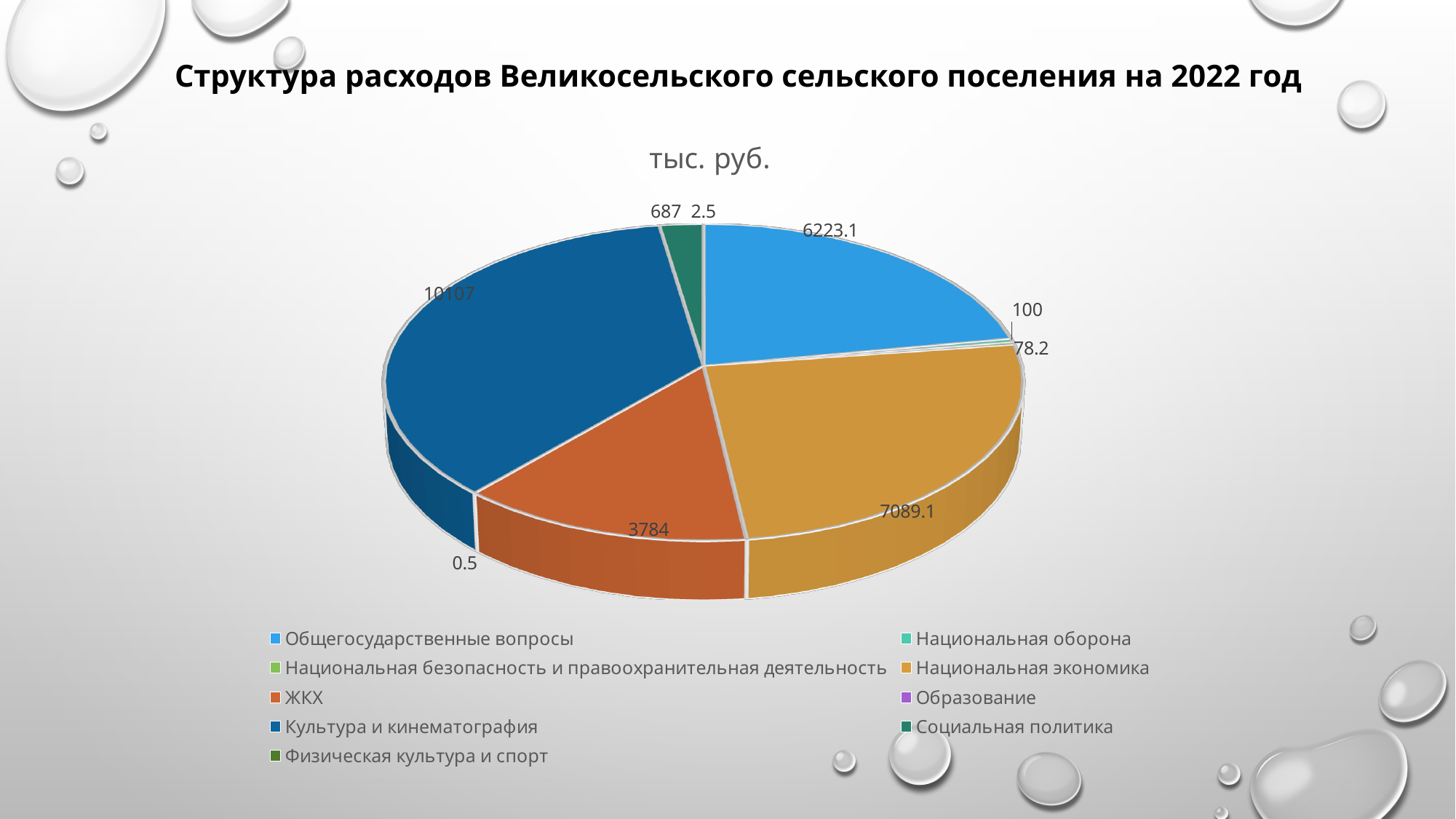
What is the title shown above the pie chart? тыс. руб. What is the value for Культура и кинематография? 10107 Which category has the largest slice of the pie? Культура и кинематография Which category has the smallest value in the pie chart? Образование What type of chart is shown on the slide? pie chart What is the difference between the values for Культура и кинематография and Национальная экономика? 3017.9 How many entries does the legend of the pie chart list? 9 What is the value for Социальная политика? 687 What is the value for Национальная экономика? 7089.1 Which is larger, the value for Общегосударственные вопросы or the value for ЖКХ? Общегосударственные вопросы What is the value for Общегосударственные вопросы? 6223.1 What is the value for ЖКХ? 3784